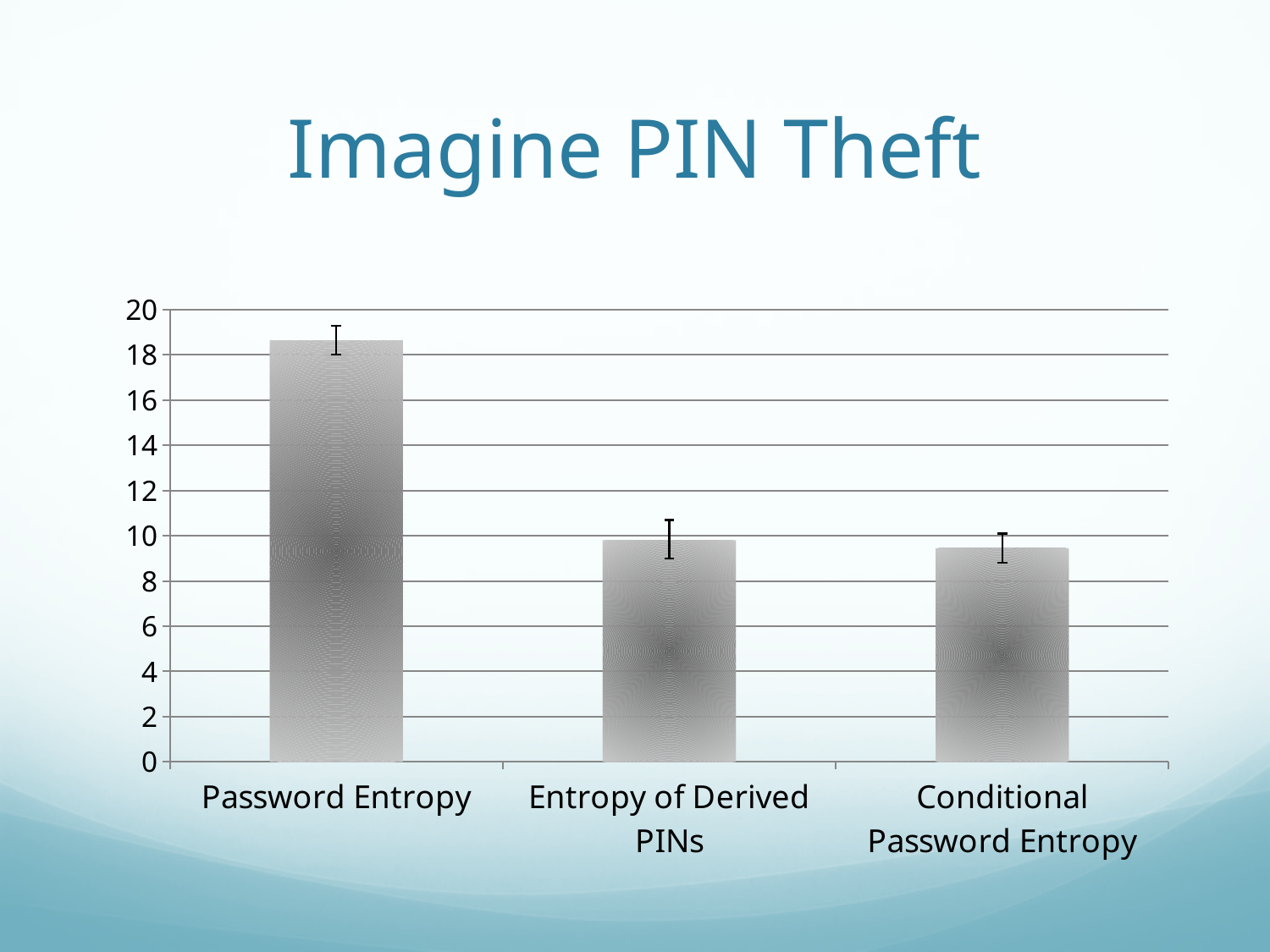
Is the value for Entropy of Derived PINs greater or less than 8? greater Which category has the highest value in the chart? Password Entropy Which is larger, the value for Password Entropy or the value for Conditional Password Entropy? Password Entropy Which is larger, the value for Password Entropy or the value for Entropy of Derived PINs? Password Entropy What is the title of the slide containing the chart? Imagine PIN Theft What is the maximum value shown on the vertical axis of the chart? 20 Do the bar values rise or fall from left to right across the categories? fall Is the value for Password Entropy greater or less than 16? greater Is the value for Conditional Password Entropy greater or less than 10? less How many categories are plotted in the chart? 3 What kind of chart is shown on the slide? bar chart